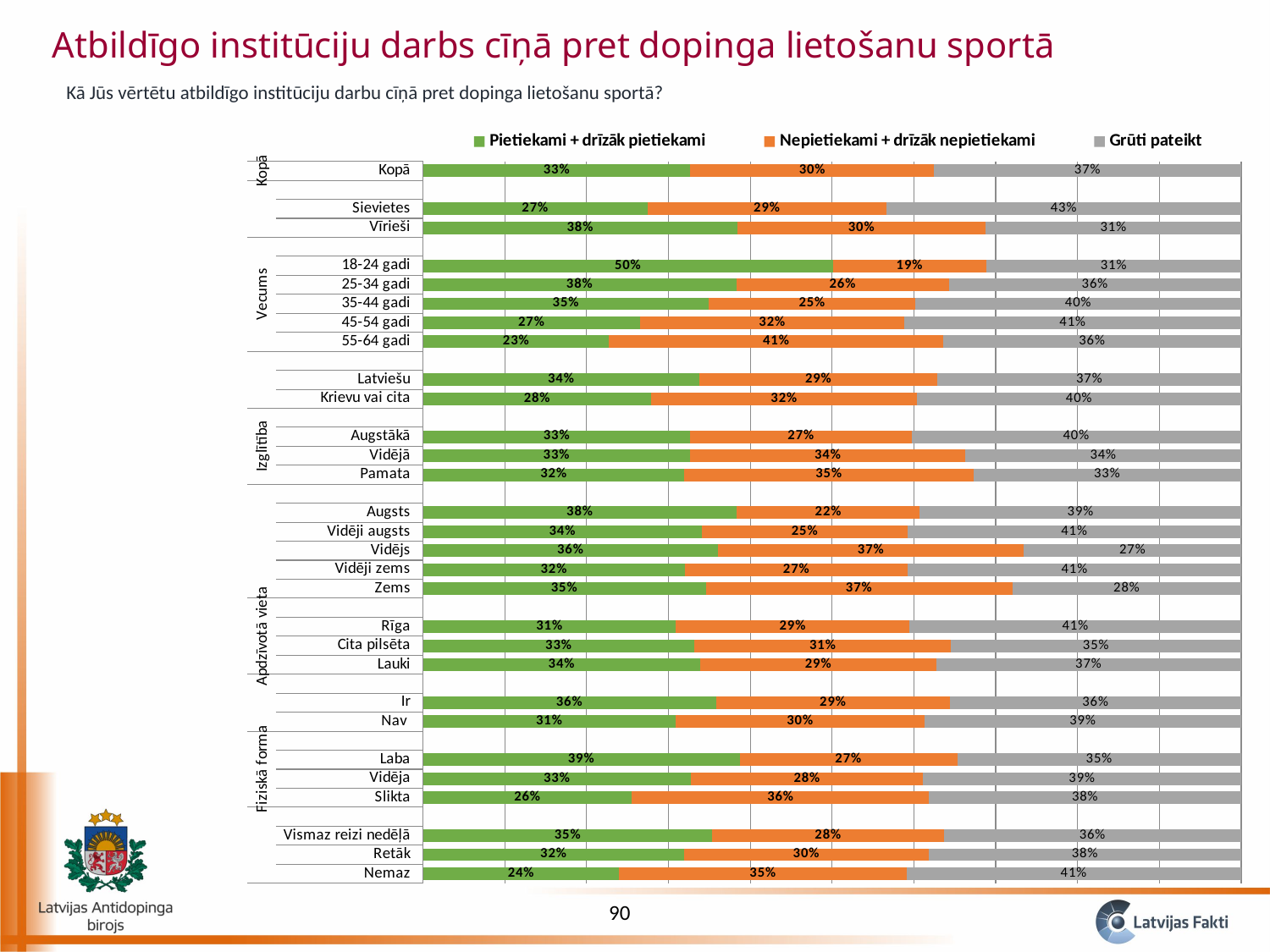
Which category has the highest "Pietiekami + drīzāk pietiekami" share? 18-24 gadi Which category has the lowest "Pietiekami + drīzāk pietiekami" share? 55-64 gadi Which has a larger "Nepietiekami + drīzāk nepietiekami" value, Slikta or Laba? Slikta What is the "Nepietiekami + drīzāk nepietiekami" value for the 55-64 gadi group? 41% How many series does the legend list? 3 What percentage of respondents in the 18-24 gadi group answered "Pietiekami + drīzāk pietiekami"? 50% What is the "Pietiekami + drīzāk pietiekami" value for Kopā? 33% How many age groups (Vecums) are shown in the chart? 5 Which colour represents the "Grūti pateikt" series? Grey What kind of chart is shown on the slide? Stacked bar chart What is the difference between the "Pietiekami + drīzāk pietiekami" values for Vīrieši and Sievietes? 11% What is the "Grūti pateikt" value for Sievietes? 43%